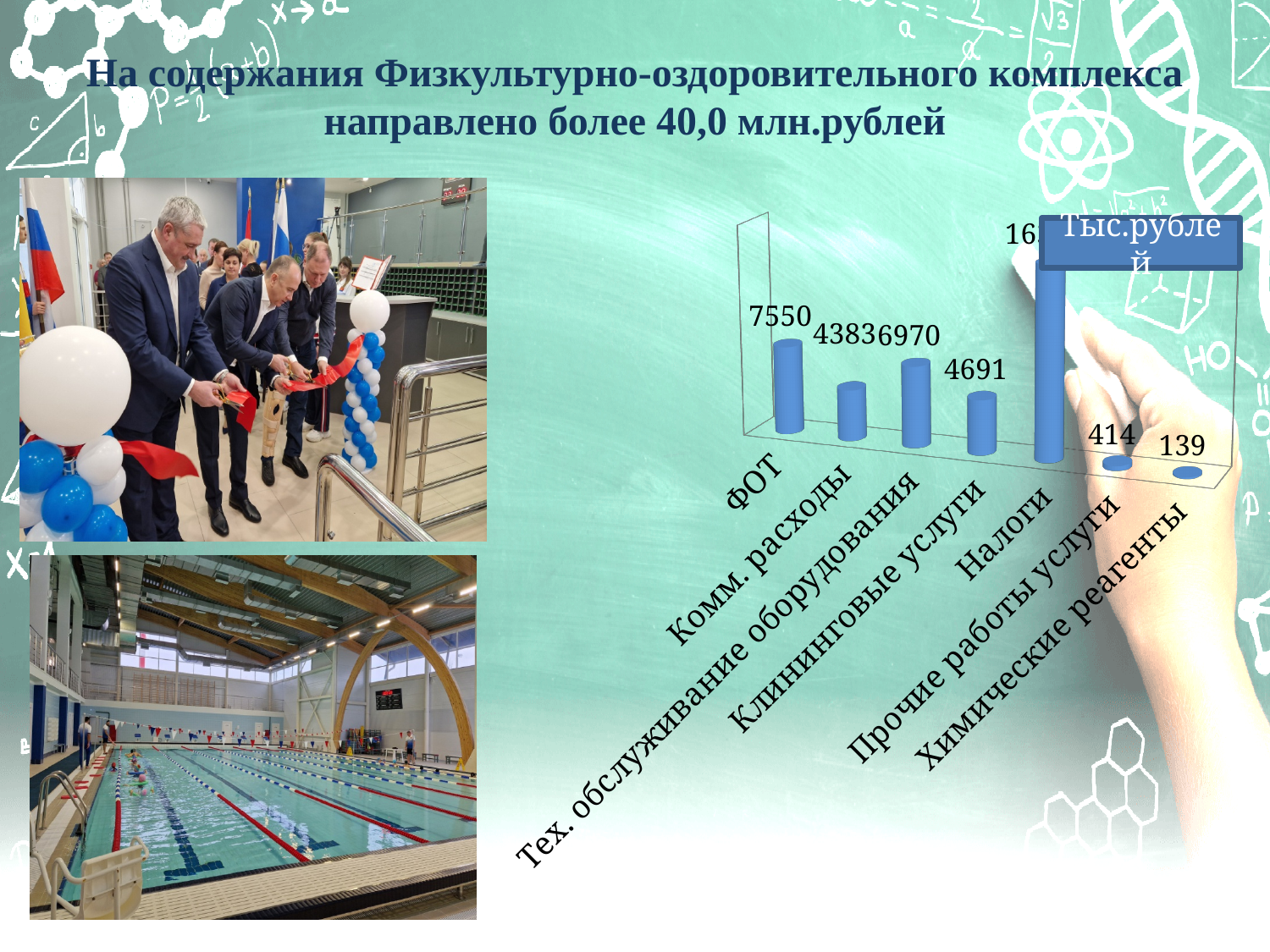
What is the difference between the values for ФОТ and Тех. обслуживание оборудования? 580 What is the value for Тех. обслуживание оборудования? 6970 Which category has the lowest value? Химические реагенты What is the value for Комм. расходы? 4383 What is the value for Химические реагенты? 139 What is the value for ФОТ? 7550 Which category has the highest value? Налоги Which is larger, the value for Комм. расходы or the value for Клининговые услуги? Клининговые услуги How many categories are shown in the chart? 7 What is the value for Клининговые услуги? 4691 What is the value for Прочие работы услуги? 414 What kind of chart is shown on the slide? Bar chart